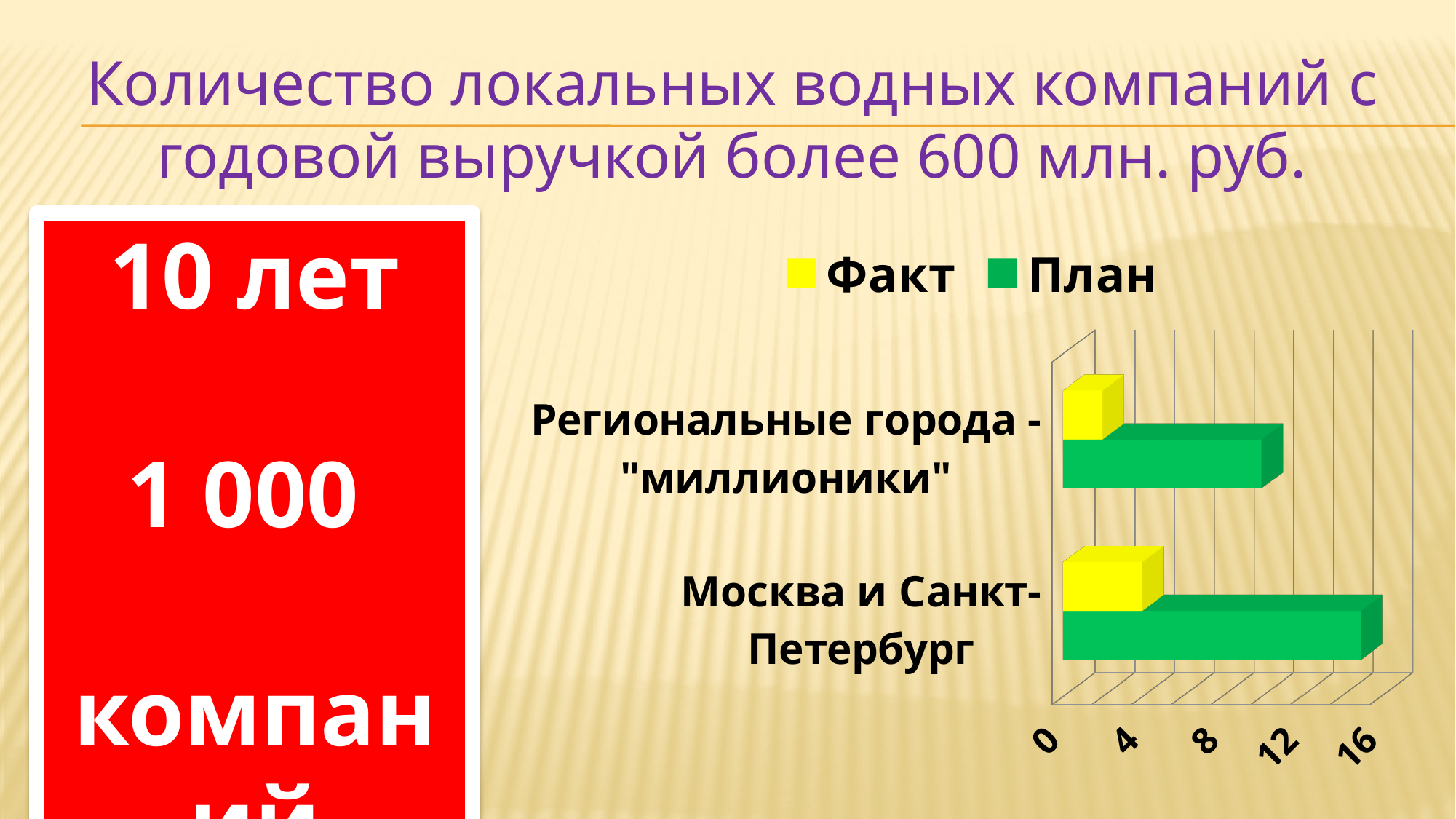
Which category has the higher План value? Москва и Санкт-Петербург Is the План value for Региональные города - "миллионики" greater or less than 8? greater Is the План value for Москва и Санкт-Петербург greater or less than 12? greater For Москва и Санкт-Петербург, which is larger: Факт or План? План Which series is shown in yellow in the chart? Факт For Региональные города - "миллионики", which is larger: Факт or План? План How many series does the chart legend list? 2 What kind of chart is shown on the slide? bar chart Which category has the lower Факт value? Региональные города - "миллионики" Which series is shown in green in the chart? План Is the Факт value for Региональные города - "миллионики" greater or less than 4? less How many categories are plotted on the chart? 2